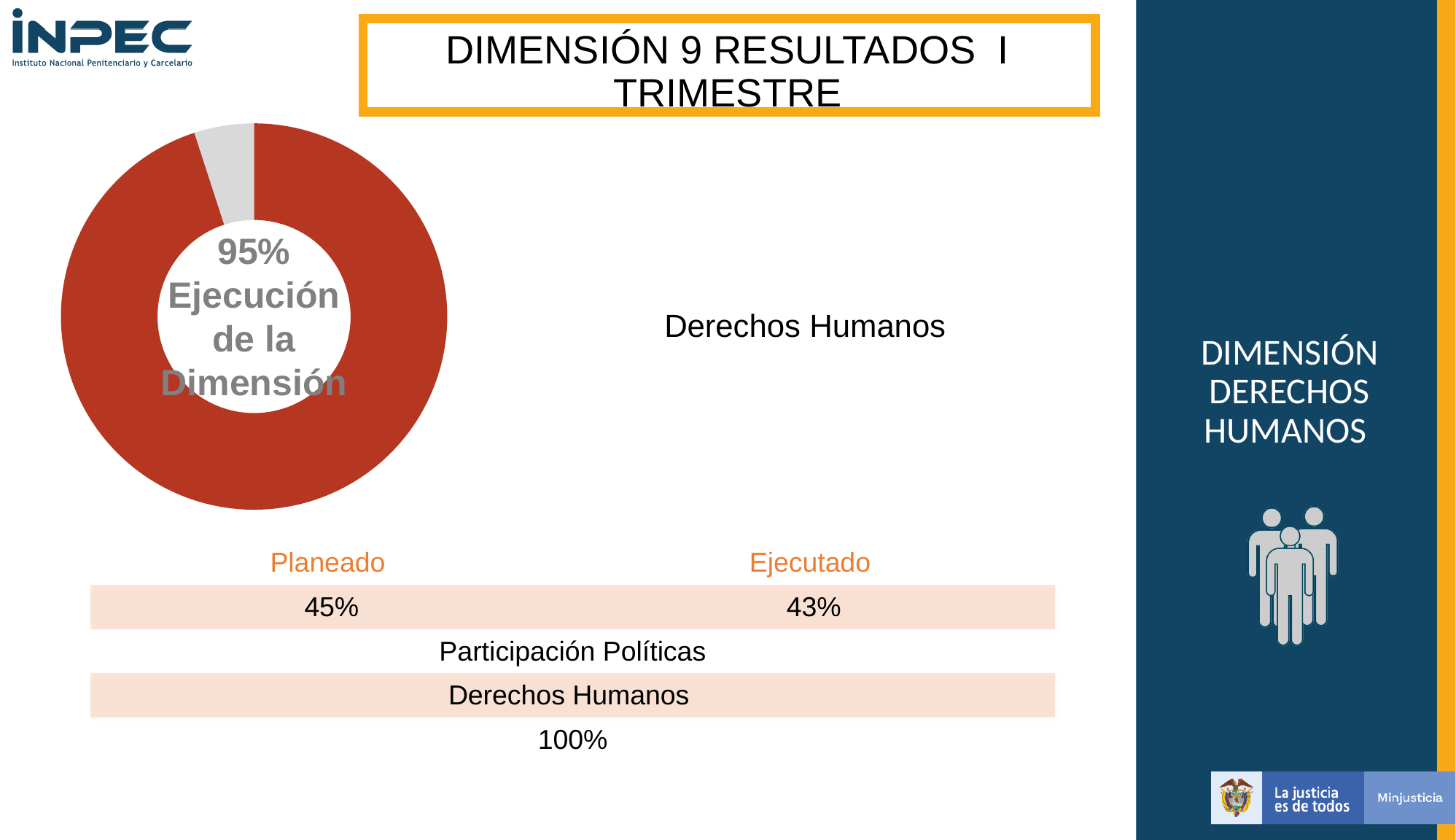
What percentage is printed in the centre of the doughnut chart? 95% What share of the doughnut chart does the red segment represent? 95% How many segments does the doughnut chart have? 2 What text is written inside the doughnut chart below the percentage? Ejecución de la Dimensión What colour is the largest segment of the doughnut chart? Red What kind of chart is shown on the left of the slide? Doughnut chart Is the value shown in the doughnut chart greater or less than 50%? greater Which segment of the doughnut chart is larger, the red one or the grey one? The red one What share of the doughnut chart does the grey segment represent? 5%